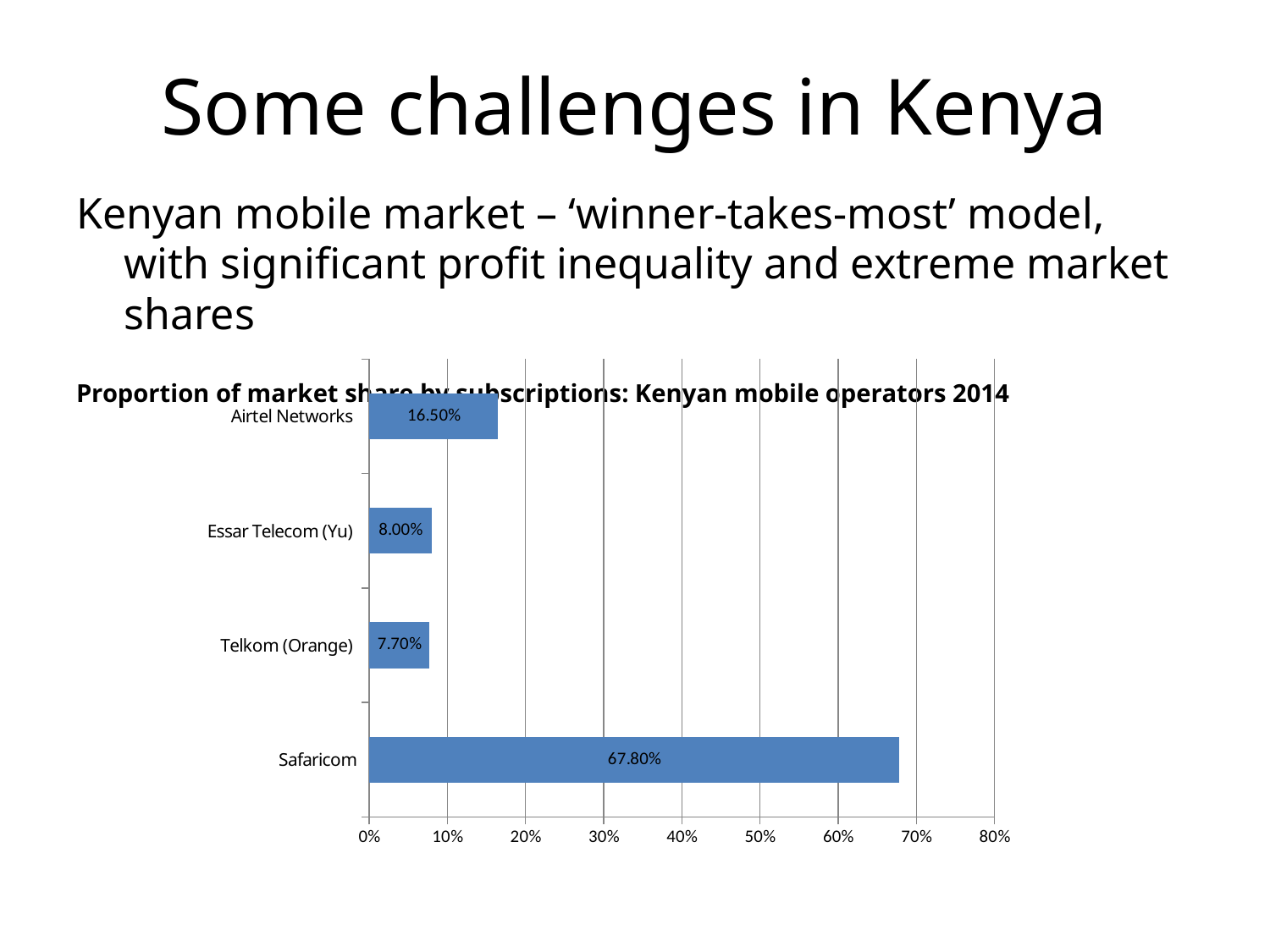
What is the difference in market share between Safaricom and Airtel Networks? 51.30% What is the market share for Airtel Networks? 16.50% What kind of chart is shown on the slide? Bar chart What is the market share for Essar Telecom (Yu)? 8.00% Which operator has the highest market share? Safaricom What is the difference in market share between Essar Telecom (Yu) and Telkom (Orange)? 0.30% What is the market share for Telkom (Orange)? 7.70% Is the value for Safaricom greater or less than 60%? greater Which operator has the lowest market share? Telkom (Orange) Which has a larger market share, Airtel Networks or Essar Telecom (Yu)? Airtel Networks What is the market share for Safaricom? 67.80% How many operators are shown in the chart? 4